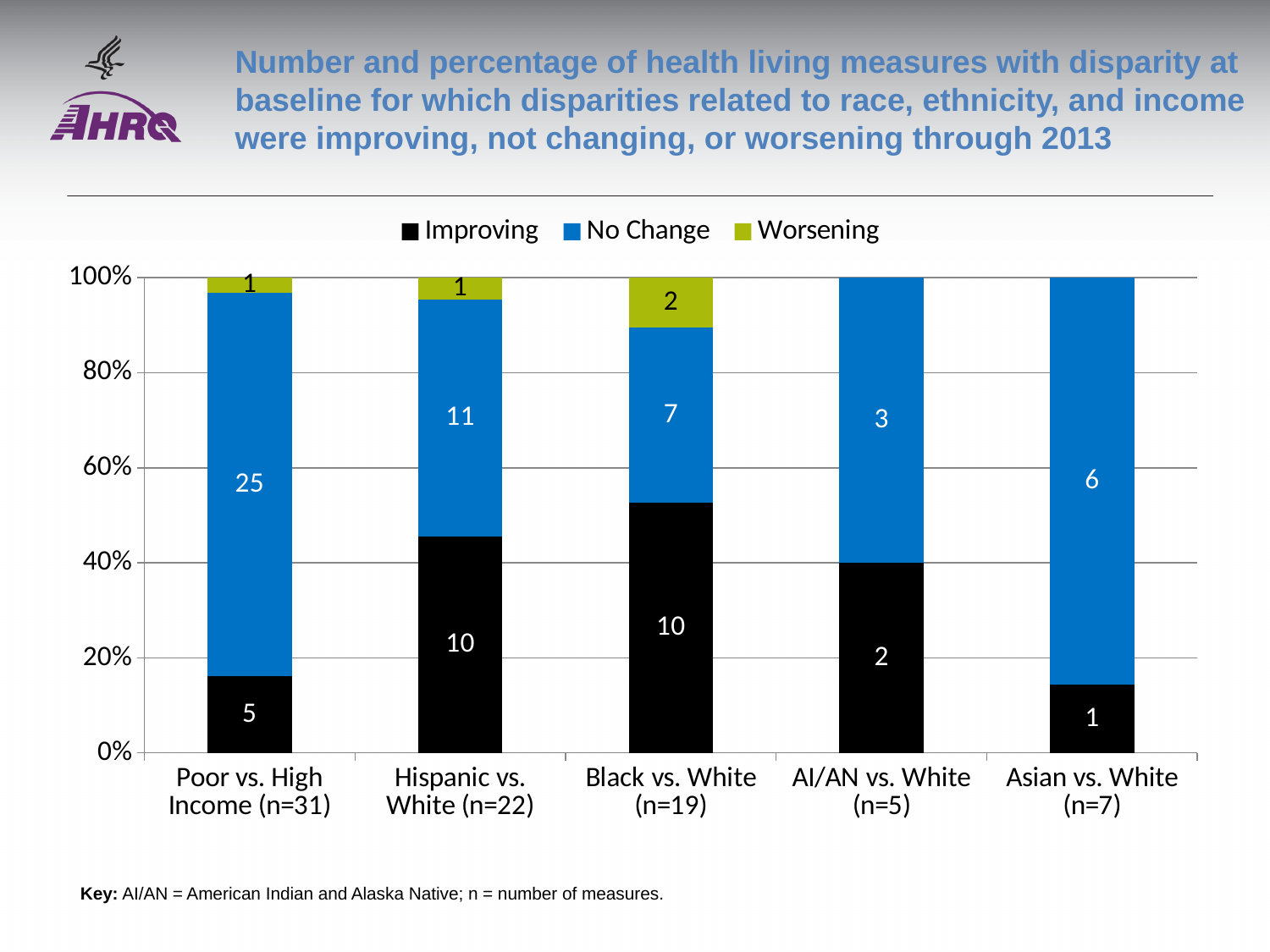
What kind of chart is shown on the slide? Stacked bar chart What is the No Change value for Asian vs. White (n=7)? 6 What is the No Change value for Hispanic vs. White (n=22)? 11 How many series does the legend list? 3 Which is larger for Black vs. White (n=19): the Improving value or the No Change value? Improving What is the total of the stacked bar for Hispanic vs. White (n=22)? 22 What is the Worsening value for Black vs. White (n=19)? 2 Which category has the lowest Improving value? Asian vs. White (n=7) Which category has the highest No Change value? Poor vs. High Income (n=31) What is the Improving value for Poor vs. High Income (n=31)? 5 How many categories are shown on the x axis? 5 What is the difference between the No Change value and the Improving value for Poor vs. High Income (n=31)? 20